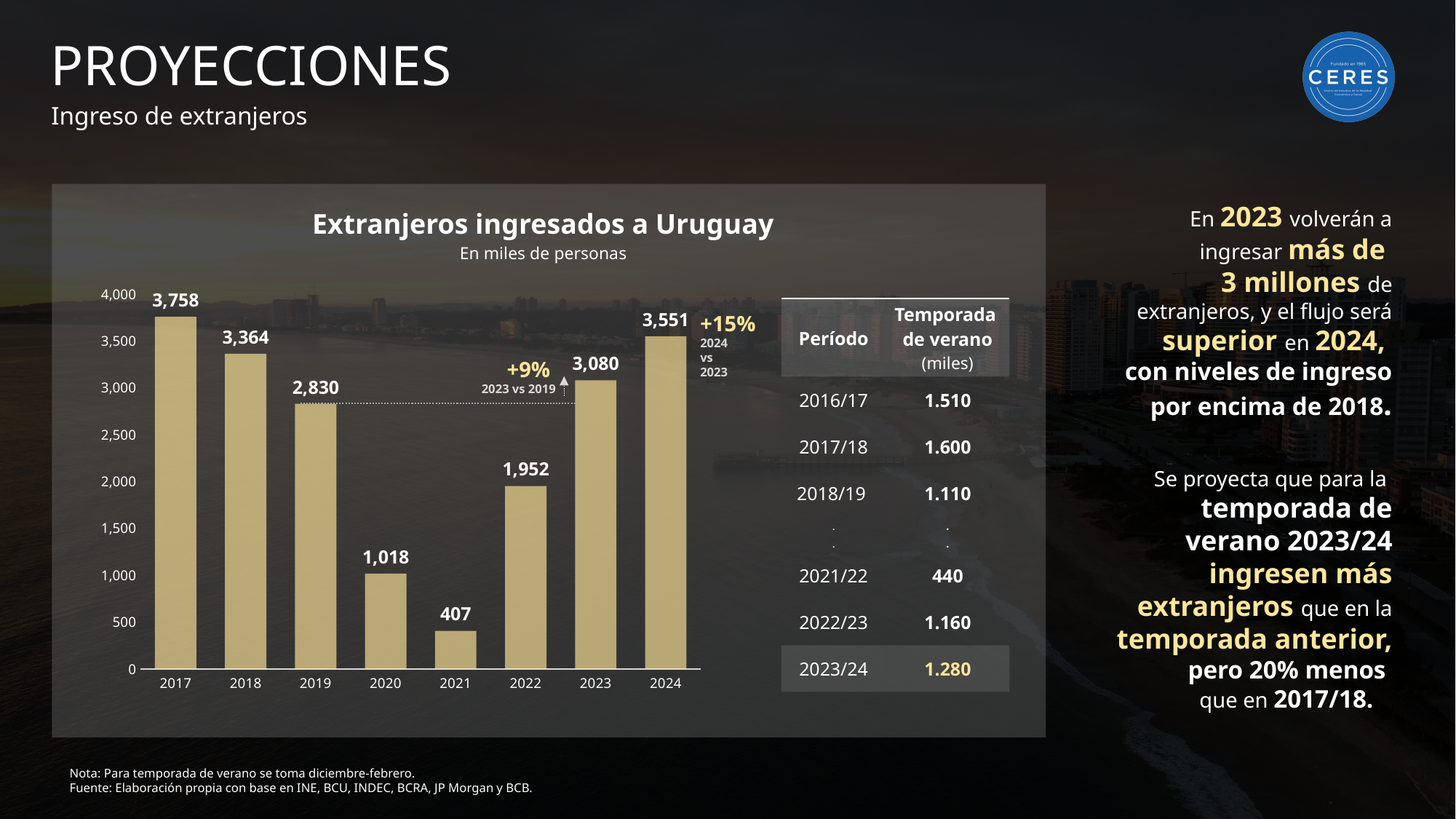
What unit is stated in the subtitle of the chart 'Extranjeros ingresados a Uruguay'? En miles de personas What is the value for 2024 in the chart 'Extranjeros ingresados a Uruguay'? 3,551 What is the value for 2021 in the chart 'Extranjeros ingresados a Uruguay'? 407 How many years are shown on the x axis of the chart 'Extranjeros ingresados a Uruguay'? 8 Is the value for 2022 in the chart 'Extranjeros ingresados a Uruguay' greater or less than 2,000? less What is the value for 2017 in the chart 'Extranjeros ingresados a Uruguay'? 3,758 What is the difference between the 2024 and 2023 values in the chart 'Extranjeros ingresados a Uruguay'? 471 Which year has the lowest value in the chart 'Extranjeros ingresados a Uruguay'? 2021 In the chart 'Extranjeros ingresados a Uruguay', do the values rise or fall from 2021 to 2024? rise In the chart 'Extranjeros ingresados a Uruguay', which is larger, the value for 2019 or the value for 2023? 2023 What kind of chart is 'Extranjeros ingresados a Uruguay'? bar chart Which year has the highest value in the chart 'Extranjeros ingresados a Uruguay'? 2017